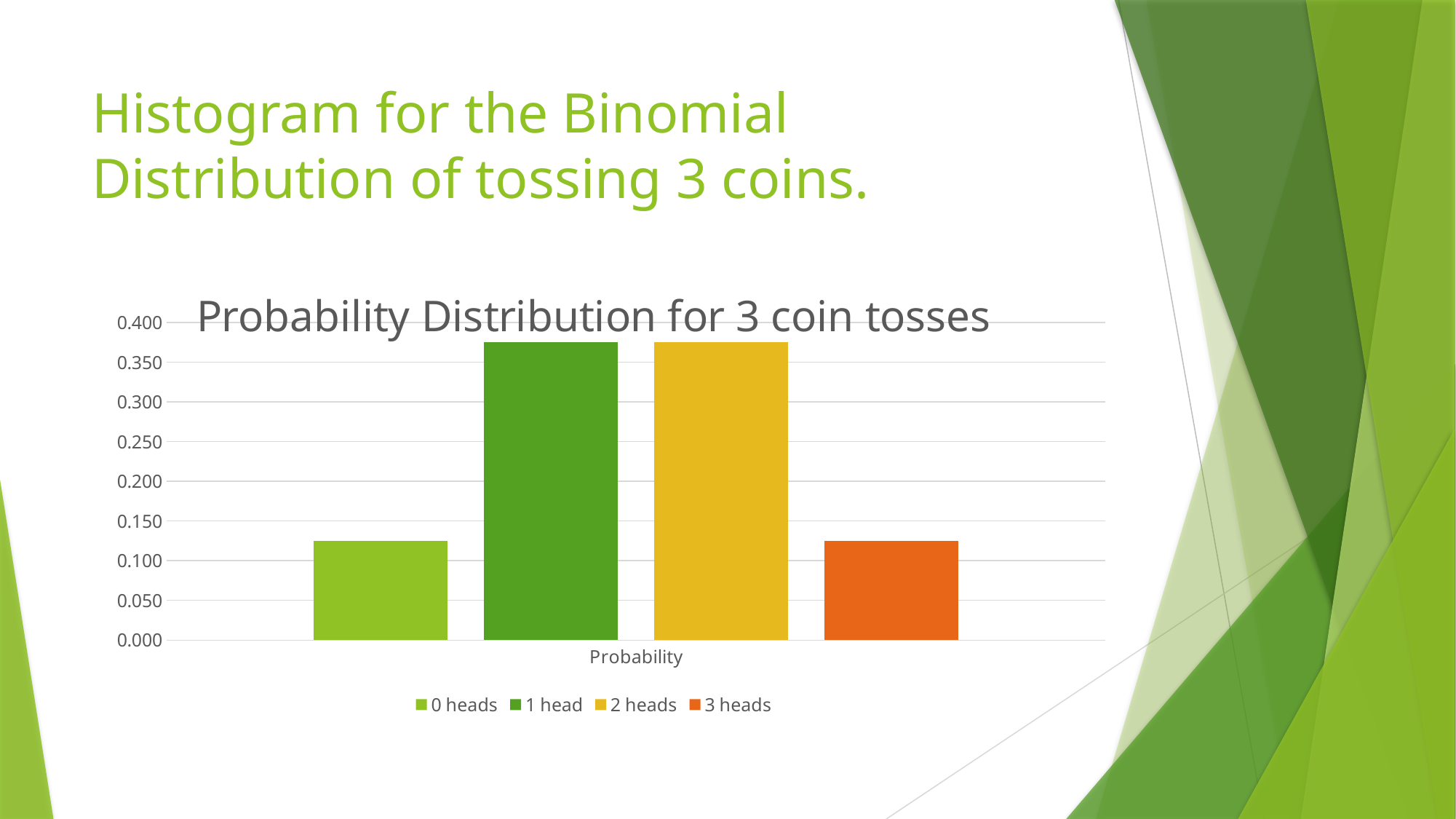
Is the value for 0 heads greater or less than 0.150? less What is the label on the x axis of the chart? Probability Is the value for 2 heads greater or less than 0.400? less Is the value for 0 heads greater or less than 0.200? less Which is larger, the value for 1 head or the value for 0 heads? 1 head How many series does the legend list? 4 Which is larger, the value for 3 heads or the value for 2 heads? 2 heads What is the title of the chart? Probability Distribution for 3 coin tosses What kind of chart is shown on the slide? bar chart